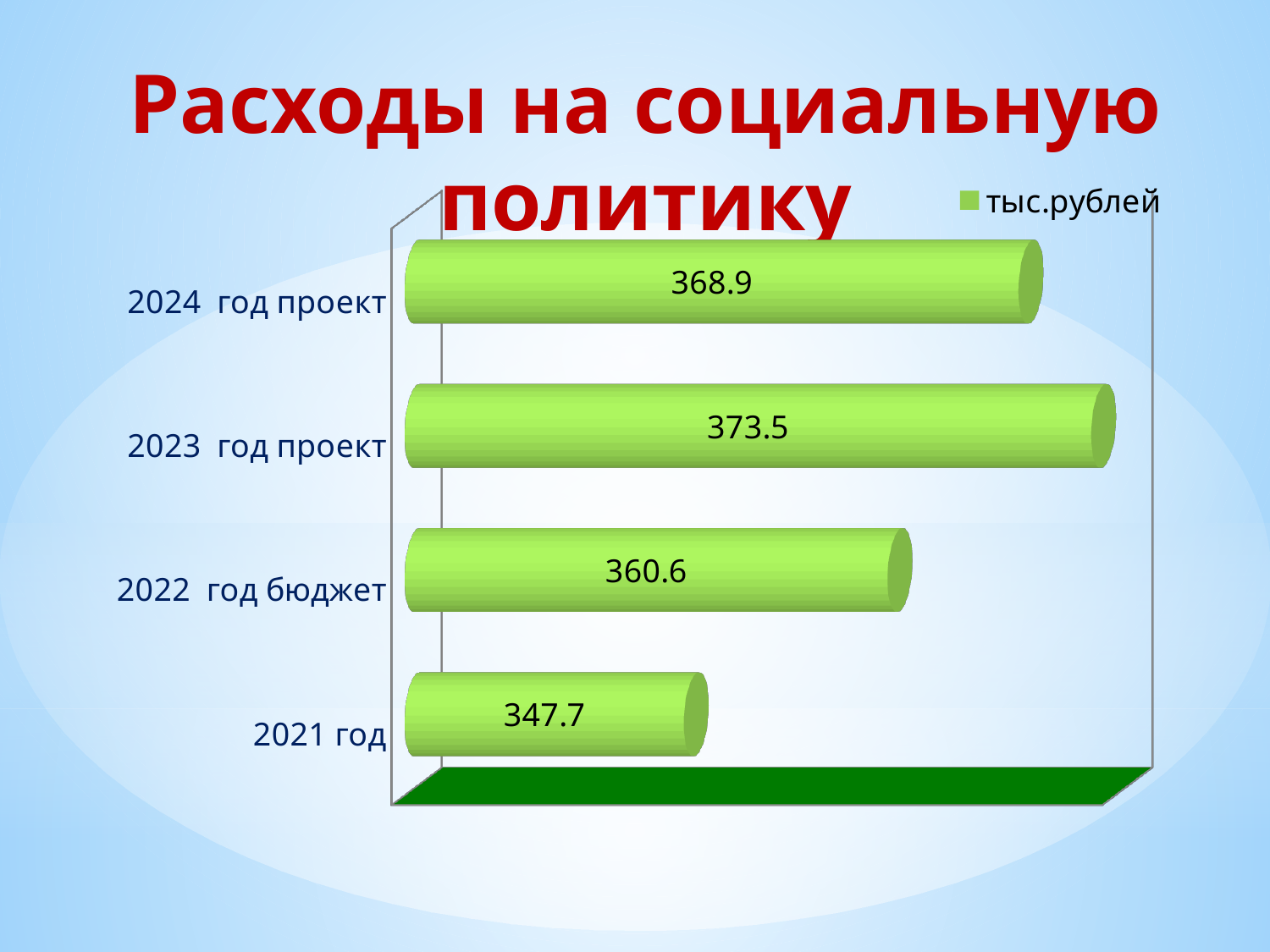
What is the difference between the values for 2024 год проект and 2022 год бюджет? 8.3 What is the difference between the values for 2023 год проект and 2021 год? 25.8 Which category has the highest value? 2023 год проект What is the value for 2021 год? 347.7 What series name does the legend show? тыс.рублей How many categories are shown in the chart? 4 What is the value for 2022 год бюджет? 360.6 What is the value for 2023 год проект? 373.5 What is the value for 2024 год проект? 368.9 Which is larger, the value for 2022 год бюджет or the value for 2024 год проект? 2024 год проект Which category has the lowest value? 2021 год What kind of chart is shown on the slide? bar chart